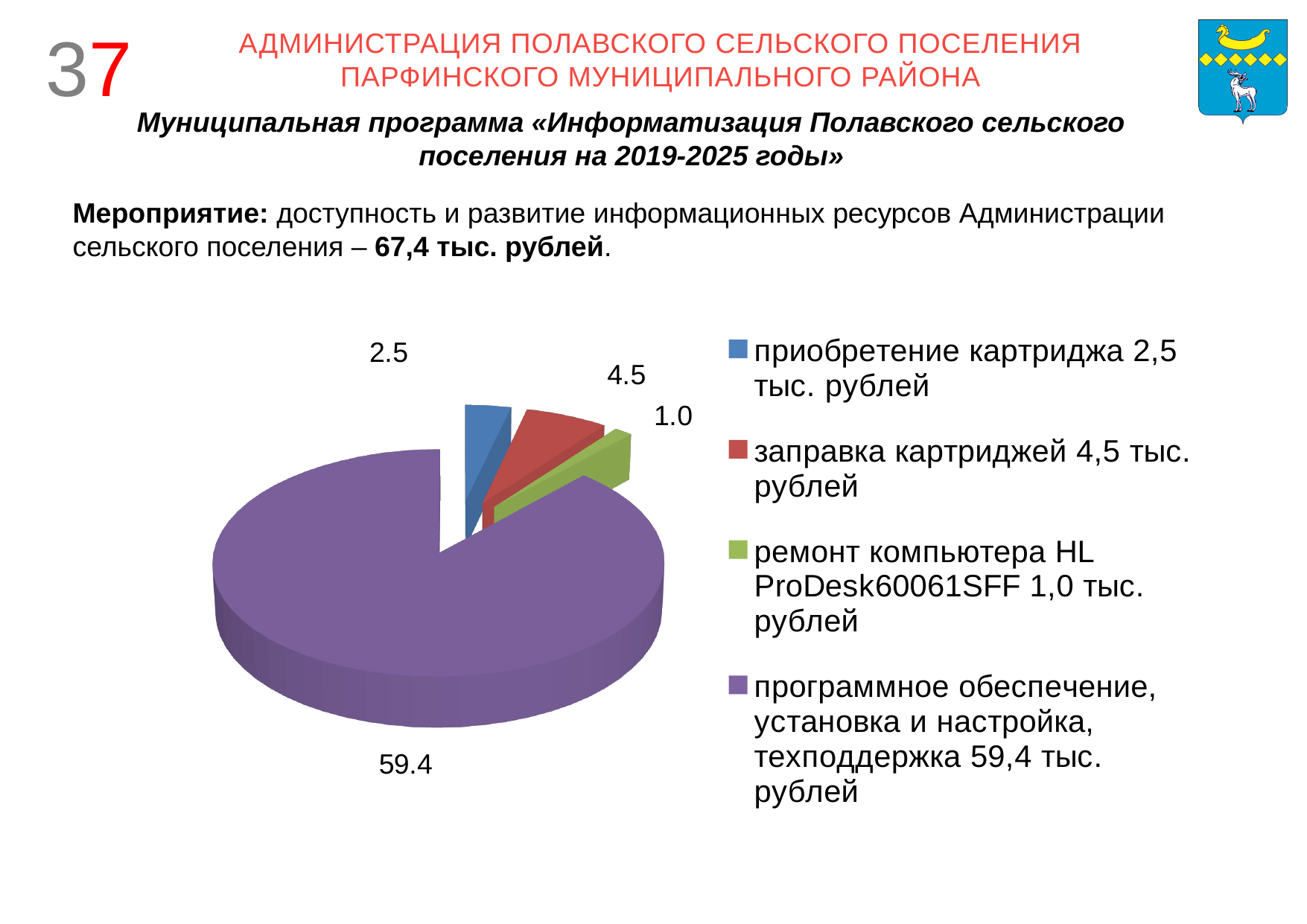
Which category has the largest slice in the pie chart? программное обеспечение, установка и настройка, техподдержка What value is shown for the slice 'ремонт компьютера HL ProDesk60061SFF'? 1.0 How many entries does the legend of the pie chart list? 4 What value is shown for the slice 'приобретение картриджа' (purchase of cartridge)? 2.5 What value is shown for the slice 'программное обеспечение, установка и настройка, техподдержка'? 59.4 Which is larger: the value for 'заправка картриджей' or the value for 'приобретение картриджа'? заправка картриджей What value is shown for the slice 'заправка картриджей' (cartridge refilling)? 4.5 What is the difference between the values for 'заправка картриджей' and 'приобретение картриджа'? 2.0 What colour is the slice for 'программное обеспечение, установка и настройка, техподдержка'? purple How many slices does the pie chart have? 4 Which category has the smallest slice in the pie chart? ремонт компьютера HL ProDesk60061SFF What type of chart is shown on the slide? pie chart